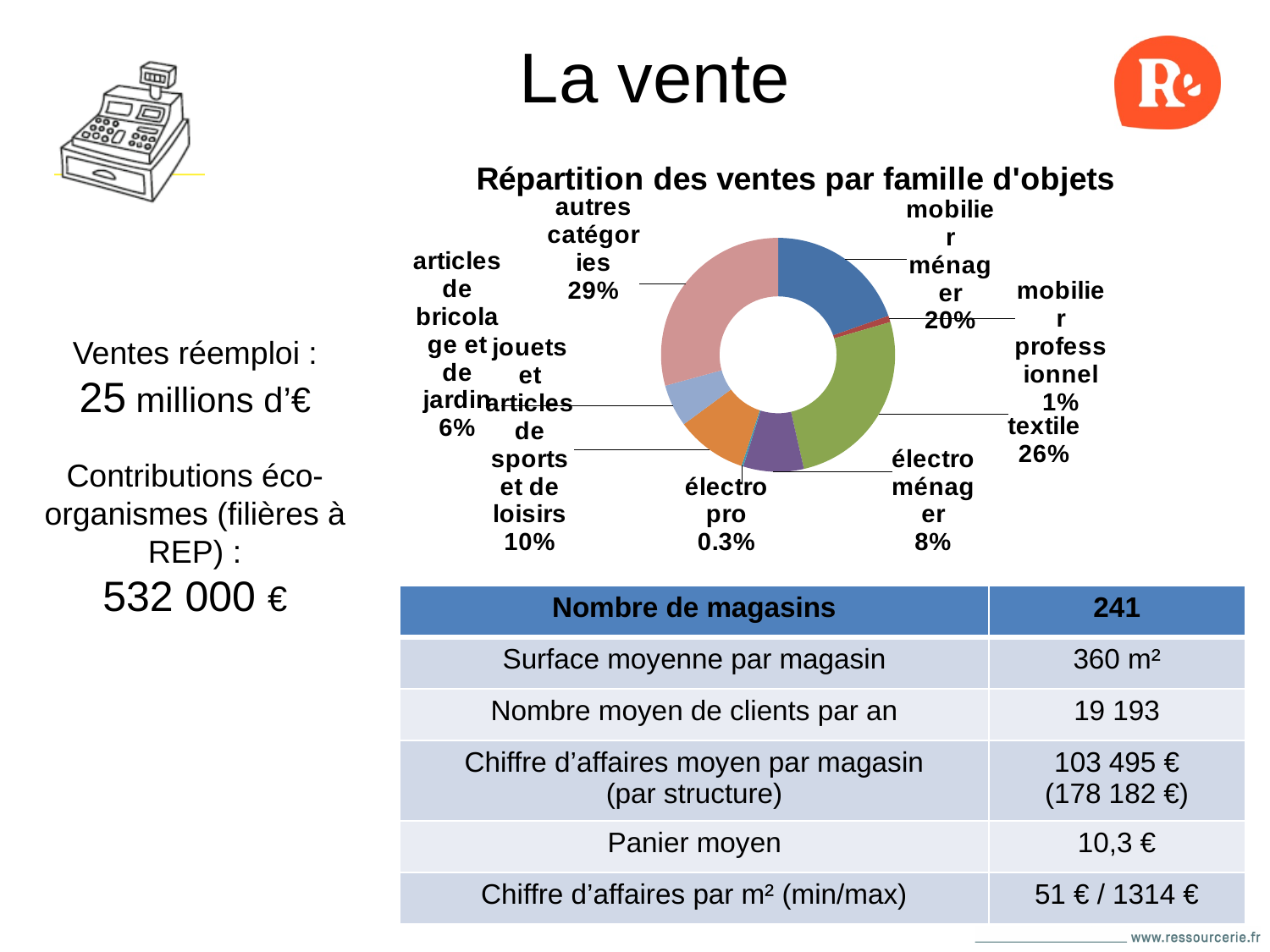
What is the difference in share between textile and mobilier ménager? 6% What share of sales does textile represent? 26% Which category has the smallest share of sales? électro pro What share of sales does mobilier ménager represent? 20% What share of sales does électro pro represent? 0.3% What is the title of the chart? Répartition des ventes par famille d'objets What share of sales does électroménager represent? 8% What share of sales do articles de sports et de loisirs represent? 10% Which has a larger share of sales, électroménager or articles de sports et de loisirs? articles de sports et de loisirs Which category has the largest share of sales? autres catégories How many categories are shown in the chart? 8 What kind of chart is shown on the slide? doughnut chart